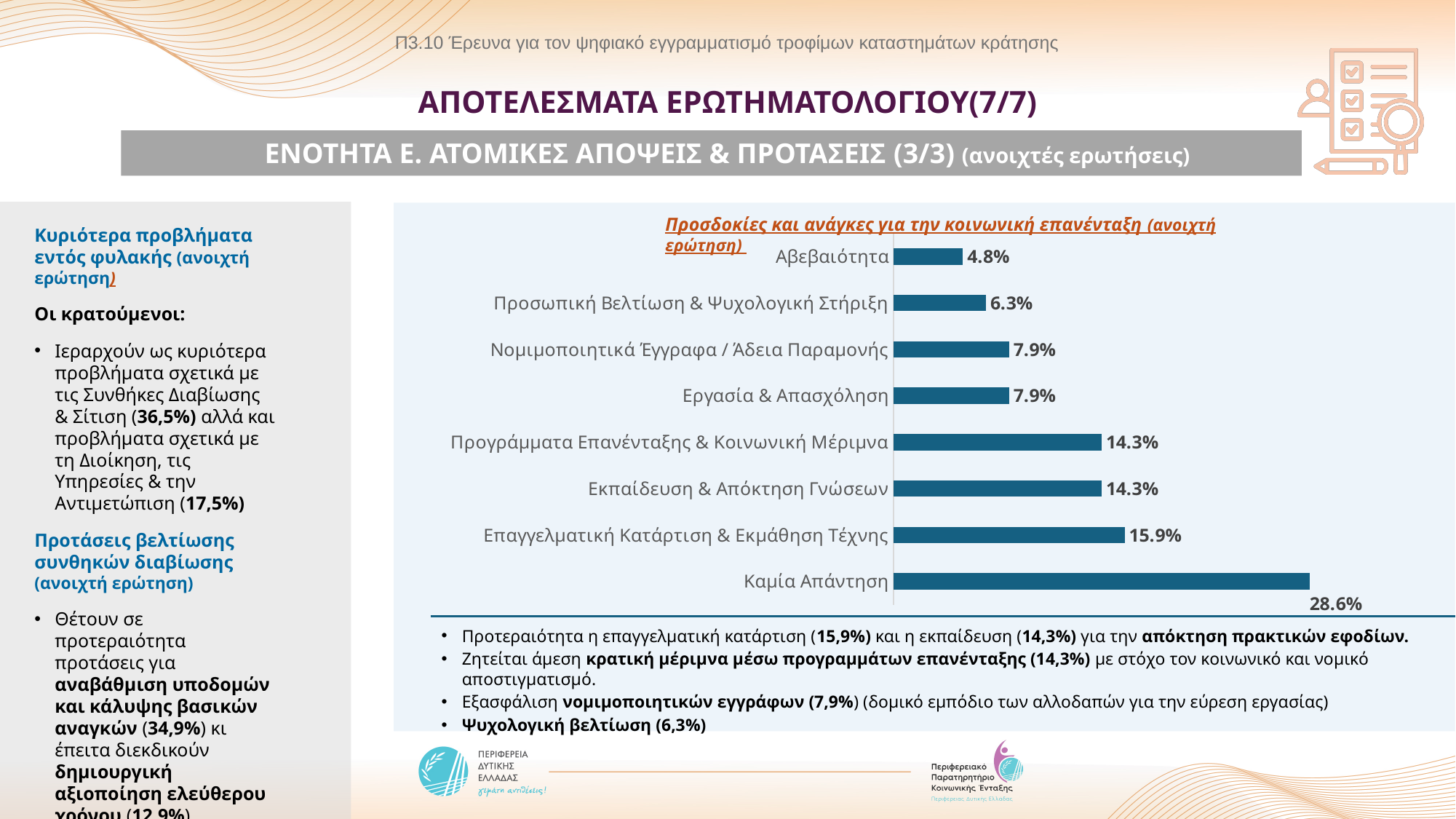
What is the difference between Προγράμματα Επανένταξης & Κοινωνική Μέριμνα and Εργασία & Απασχόληση? 6.4% Which category has the lowest value? Αβεβαιότητα What is the value for Αβεβαιότητα? 4.8% What is the value for Επαγγελματική Κατάρτιση & Εκμάθηση Τέχνης? 15.9% How many categories are shown in the chart? 8 What is the value for Προσωπική Βελτίωση & Ψυχολογική Στήριξη? 6.3% What kind of chart is shown? Bar chart Which category has the highest value? Καμία Απάντηση What is the difference between Καμία Απάντηση and Επαγγελματική Κατάρτιση & Εκμάθηση Τέχνης? 12.7% What is the value for Νομιμοποιητικά Έγγραφα / Άδεια Παραμονής? 7.9% What is the title of the chart? Προσδοκίες και ανάγκες για την κοινωνική επανένταξη (ανοιχτή ερώτηση) Which is larger, Εκπαίδευση & Απόκτηση Γνώσεων or Αβεβαιότητα? Εκπαίδευση & Απόκτηση Γνώσεων